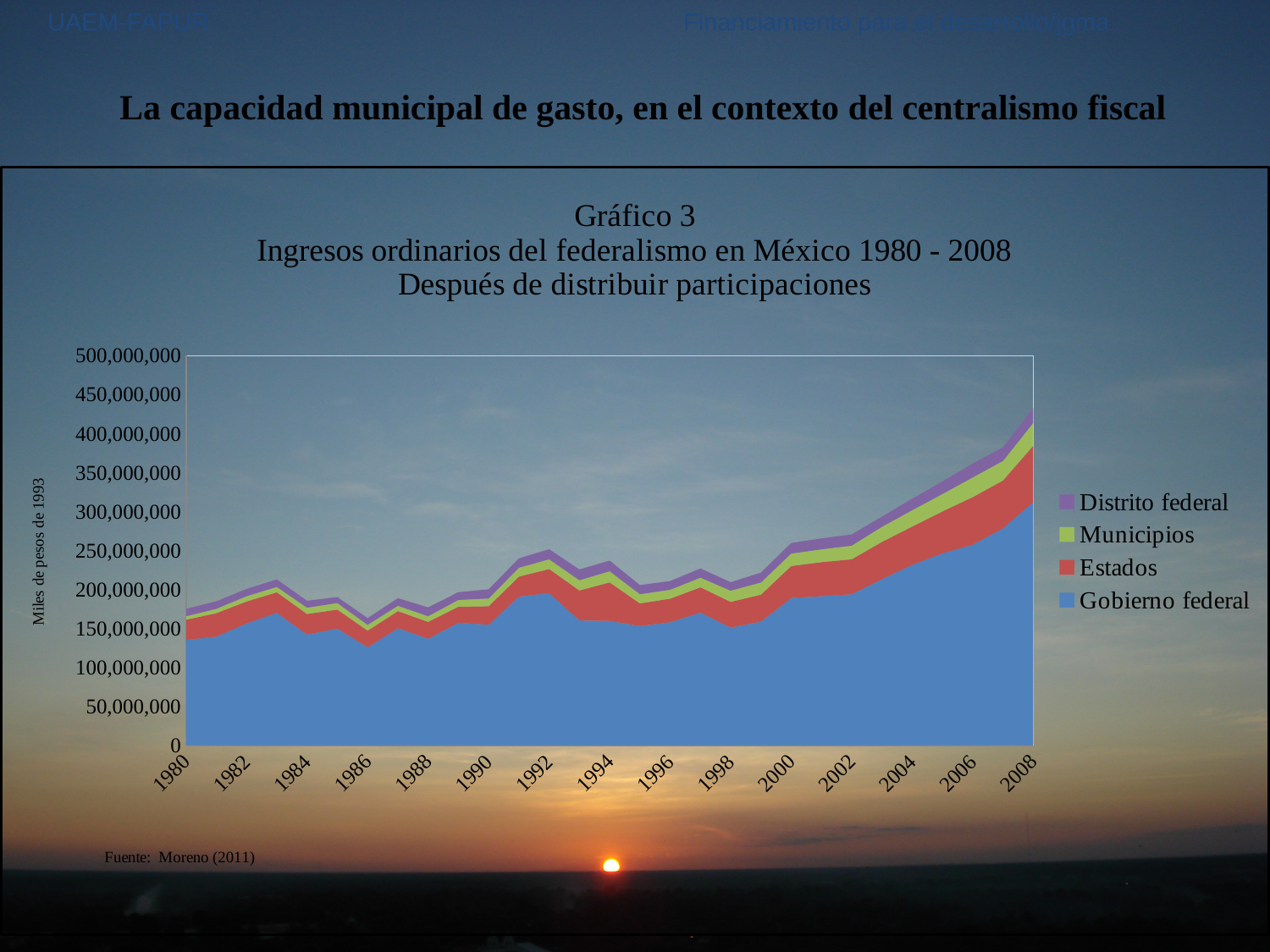
Which series is shown at the bottom of the stack in Gráfico 3? Gobierno federal Is the total of all series in 2004 greater or less than 300,000,000? greater Does the total of all series in Gráfico 3 generally rise or fall between 2000 and 2008? rise Is the value for Gobierno federal in 2004 greater or less than 200,000,000? greater Which is larger in 2008: the value for Gobierno federal or the value for Estados? Gobierno federal Is the total of all series in 2008 greater or less than 400,000,000? greater What is the unit given on the vertical axis of Gráfico 3? Miles de pesos de 1993 What kind of chart is Gráfico 3? Stacked area chart Which series accounts for the largest share of the total in Gráfico 3? Gobierno federal How many series does the legend of Gráfico 3 list? 4